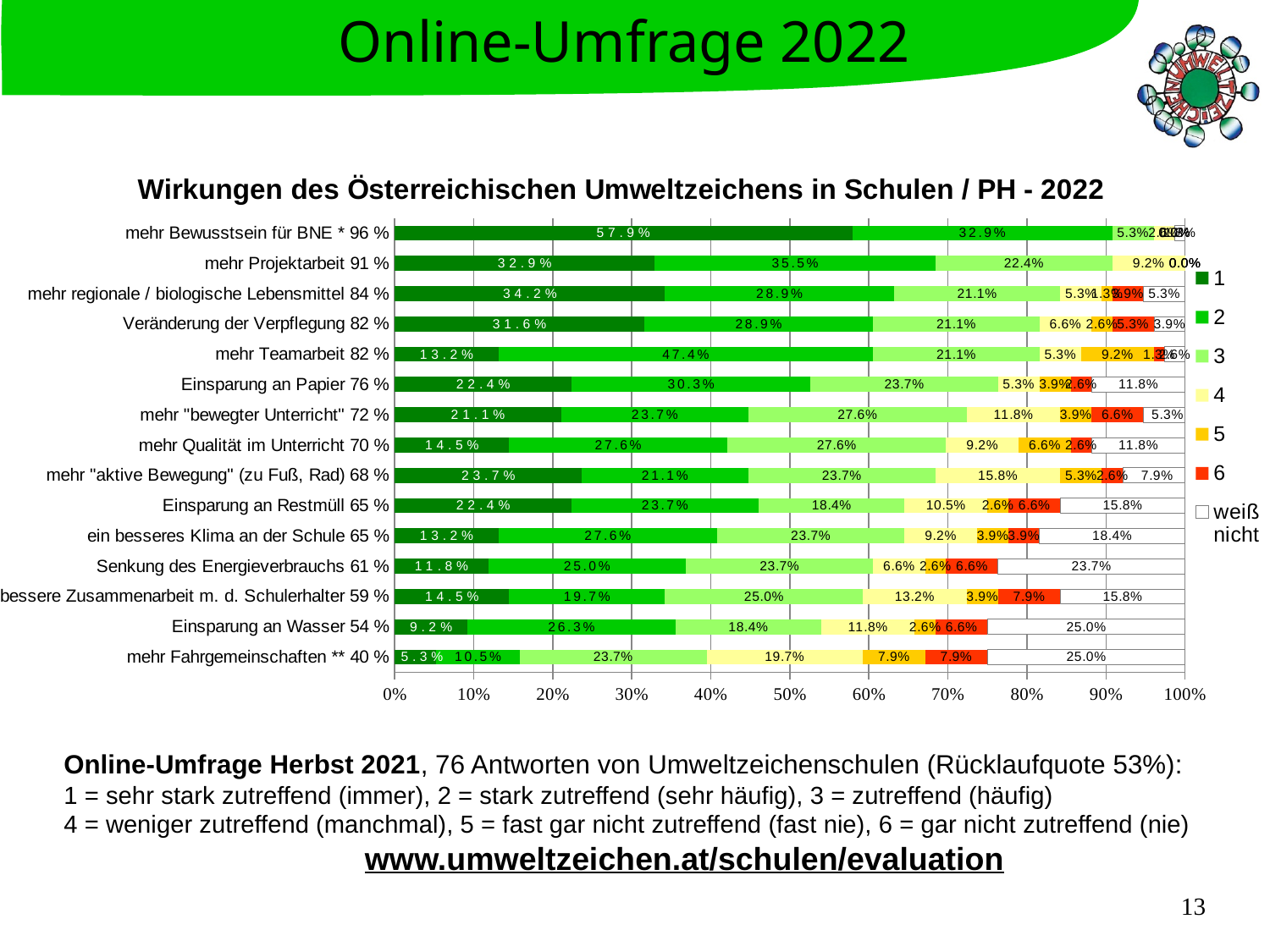
What is the title of the chart? Wirkungen des Österreichischen Umweltzeichens in Schulen / PH - 2022 What is the value of series 3 for "mehr "bewegter Unterricht" 72 %"? 27.6% Which category has the lowest value for series 1? mehr Fahrgemeinschaften ** 40 % Which is larger: the series 2 value for "mehr Projektarbeit 91 %" or the series 2 value for "Einsparung an Papier 76 %"? mehr Projektarbeit 91 % Which category has the highest value for series 1? mehr Bewusstsein für BNE * 96 % How many series does the legend list? 7 How many categories (rows) does the chart show? 15 What is the value of series 1 for "mehr Bewusstsein für BNE * 96 %"? 57.9% What is the value of series 2 for "mehr Teamarbeit 82 %"? 47.4% What kind of chart is shown on the slide? stacked bar chart What is the "weiß nicht" value for "Einsparung an Wasser 54 %"? 25.0% What is the difference between the series 1 values for "mehr Projektarbeit 91 %" and "mehr Teamarbeit 82 %"? 19.7%